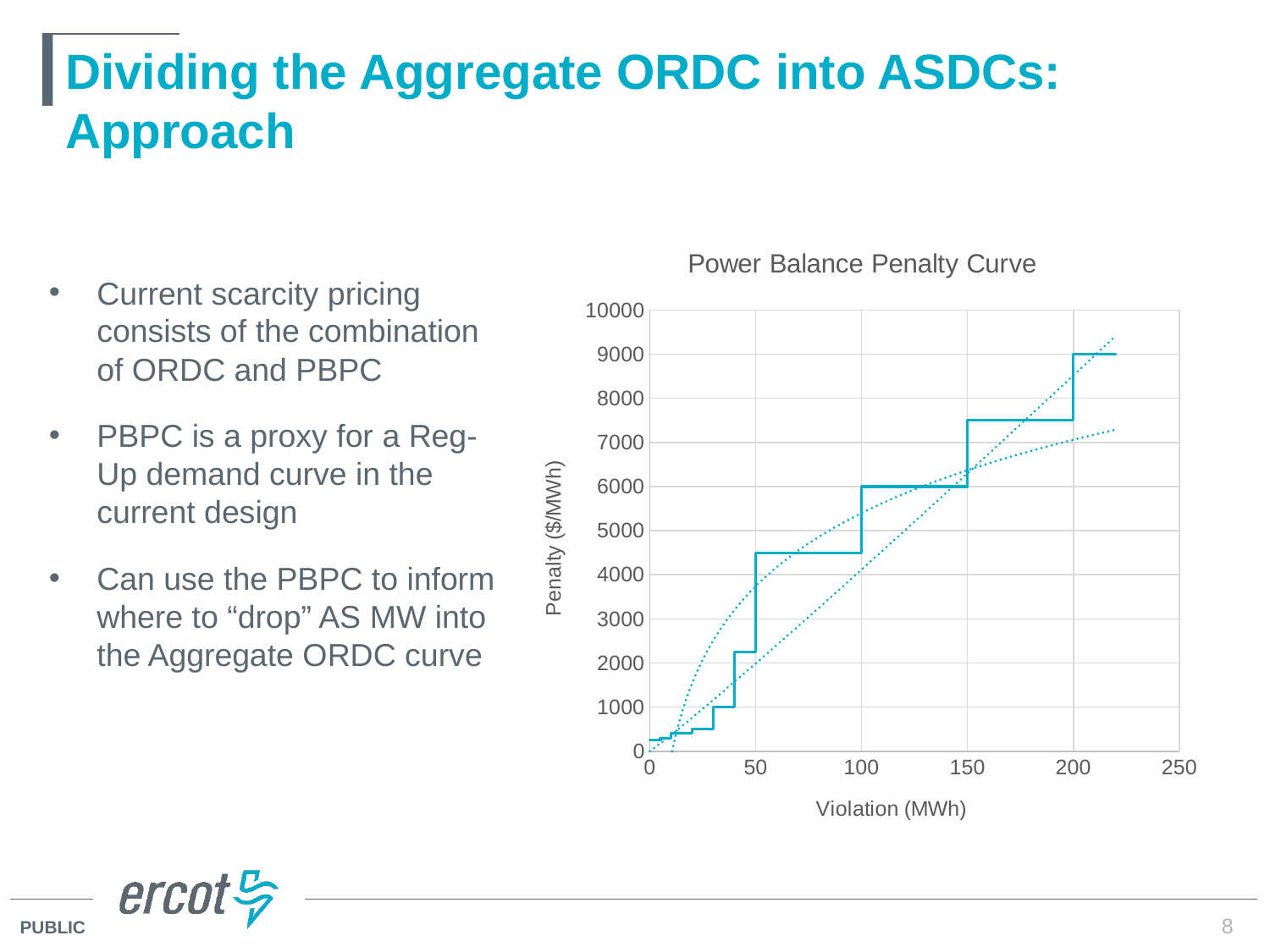
What is the highest value shown on the y axis of the chart? 10000 What is the penalty on the solid step curve for a violation of 210 MWh? 9000 Does the penalty rise or fall as the violation increases along the x axis? rise What type of chart is shown on the slide? line chart Is the penalty on the solid step curve at a violation of 175 MWh greater or less than 7000? greater What is the label of the x axis of the chart? Violation (MWh) What is the penalty on the solid step curve for a violation of 120 MWh? 6000 Is the penalty on the solid step curve at a violation of 175 MWh greater or less than 8000? less What is the title of the chart? Power Balance Penalty Curve Which has the higher penalty on the solid step curve: a violation of 75 MWh or a violation of 175 MWh? 175 MWh Is the penalty on the solid step curve at a violation of 45 MWh greater or less than 2000? greater